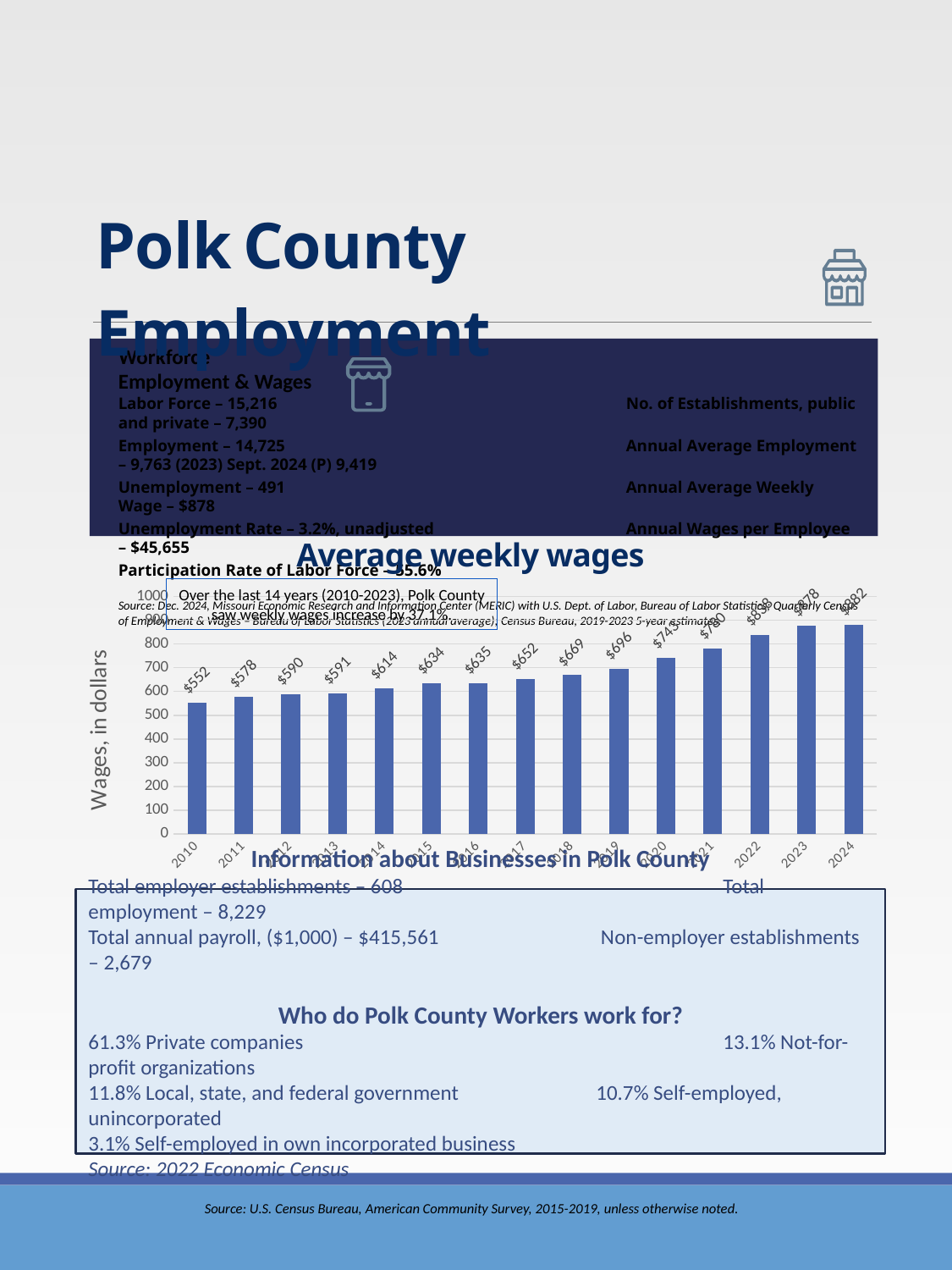
Which year has the highest average weekly wage on the chart? 2024 What is the average weekly wage shown for 2021? $780 How much higher is the average weekly wage in 2020 than in 2019? $47 Which year has the lowest average weekly wage on the chart? 2010 What type of chart is used to show Average weekly wages? bar chart Is the average weekly wage for 2022 greater or less than 800? greater What is the average weekly wage shown for 2019? $696 What is the average weekly wage shown for 2010? $552 How many years are plotted on the Average weekly wages chart? 15 What is the difference between the average weekly wage in 2014 and in 2010? $62 Which year has a higher average weekly wage, 2017 or 2018? 2018 Do average weekly wages rise or fall from 2010 to 2024? rise